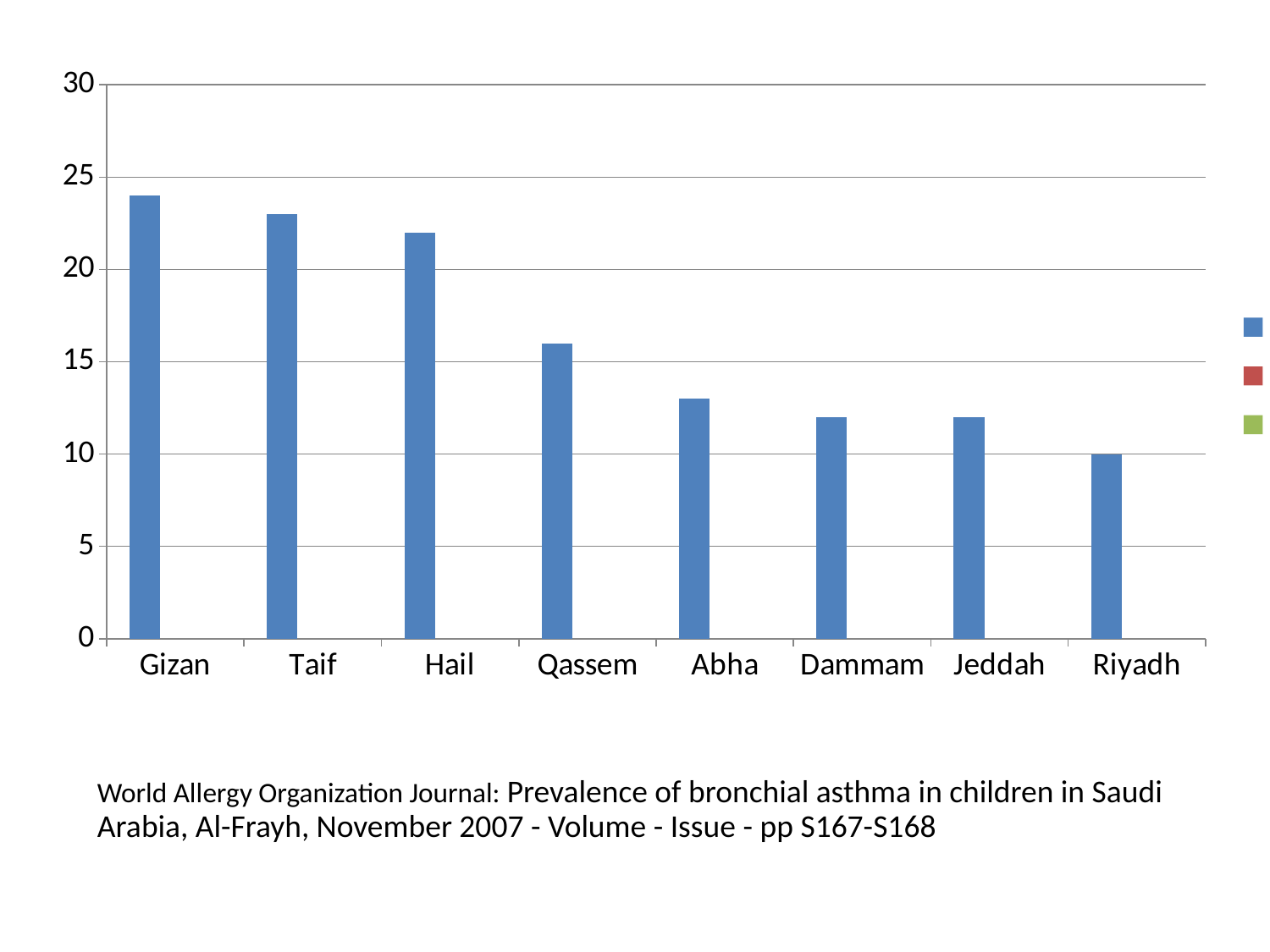
How many cities are shown on the x axis of the chart? 8 Which city has the lowest value in the chart? Riyadh Which city has the highest value in the chart? Gizan Is the value for Abha greater or less than 15? less Is the value for Dammam greater or less than 10? greater What kind of chart is shown on the slide? bar chart Is the value for Qassem greater or less than 15? greater What is the value for Riyadh? 10 Do the values generally rise or fall from Gizan to Riyadh along the x axis? fall Which has the larger value, Hail or Abha? Hail